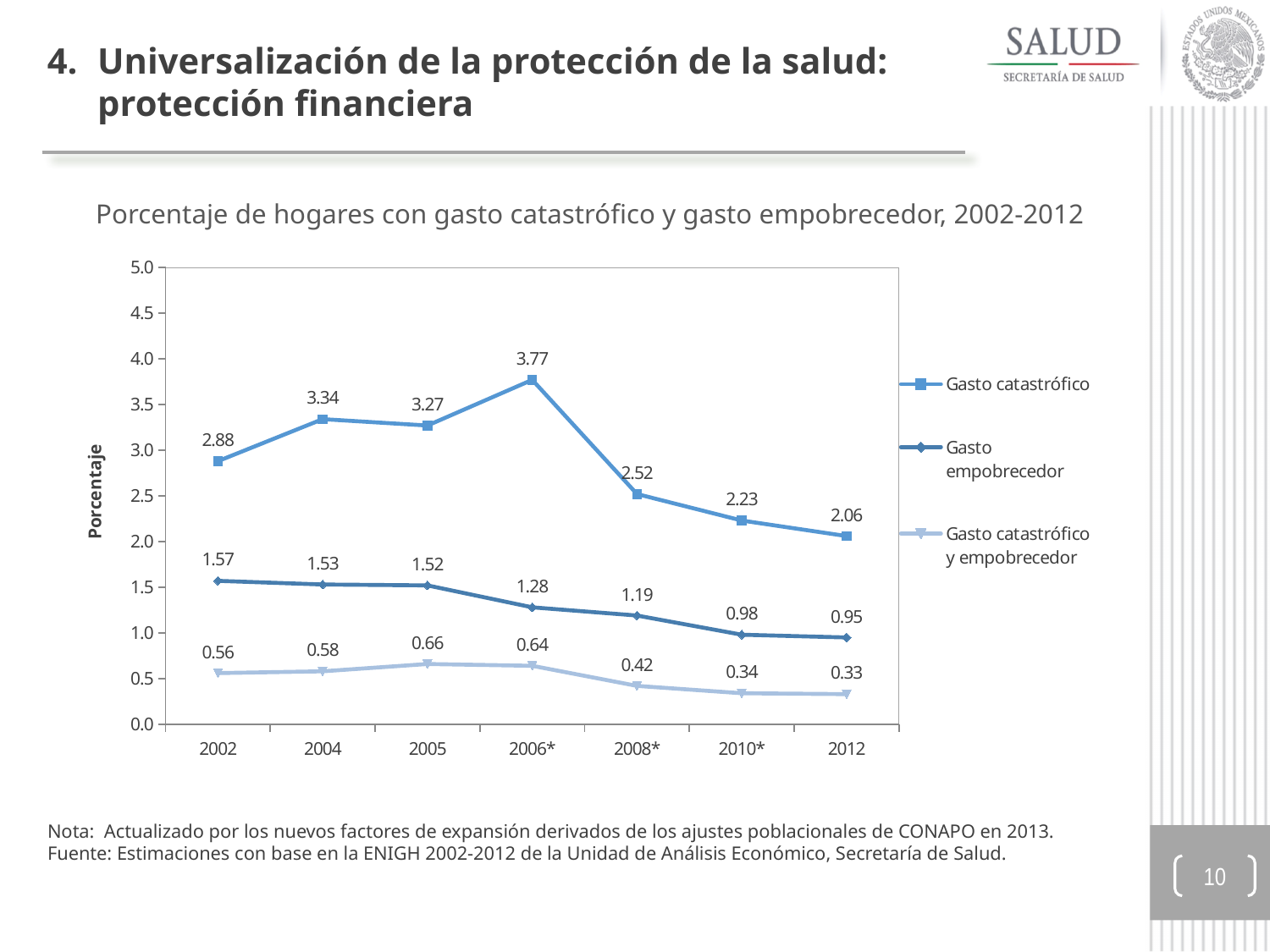
What is the value for Gasto catastrófico y empobrecedor in 2005? 0.66 What is the value for Gasto catastrófico in 2006*? 3.77 What is the difference between Gasto catastrófico in 2006* and in 2012? 1.71 In which year is Gasto catastrófico highest? 2006* In which year is Gasto catastrófico y empobrecedor lowest? 2012 Does Gasto empobrecedor rise or fall from 2002 to 2012? fall What kind of chart is shown on the slide? line chart What is the value for Gasto empobrecedor in 2012? 0.95 Is the value for Gasto catastrófico in 2004 greater or less than 3.0? greater How many years are shown on the x axis? 7 How many series does the legend list? 3 Which is larger, Gasto empobrecedor in 2002 or Gasto empobrecedor in 2008*? 2002